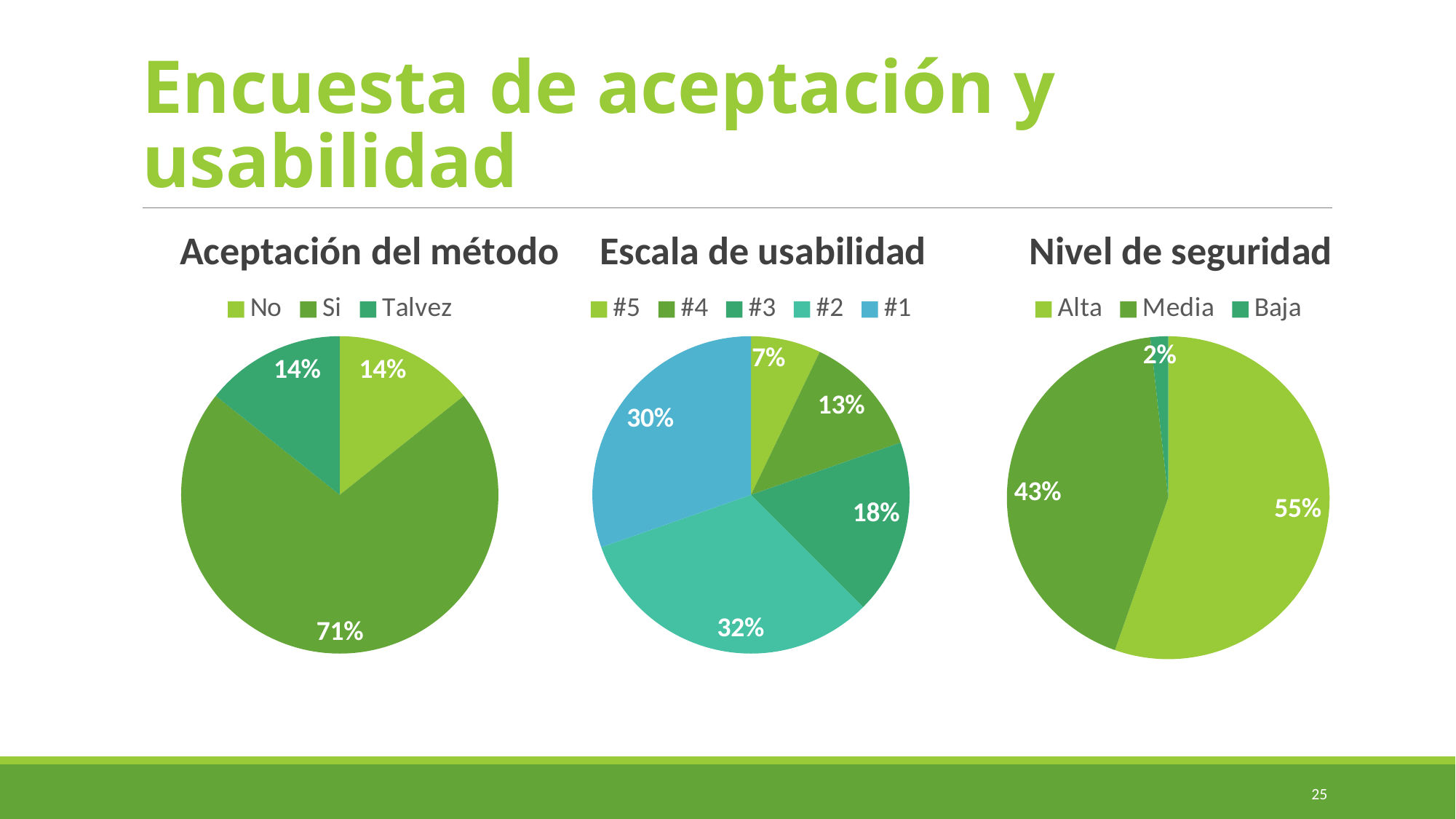
In the 'Escala de usabilidad' chart, what share does '#2' have? 32% In the 'Escala de usabilidad' chart, which is larger, '#4' or '#3'? #3 How many charts are shown on the slide? 3 In the 'Escala de usabilidad' chart, how many slices does the pie have? 5 In the 'Escala de usabilidad' chart, what is the difference between the shares of '#1' and '#3'? 12% In the 'Aceptación del método' chart, which category has the largest slice? Si In the 'Nivel de seguridad' chart, what share does 'Baja' have? 2% In the 'Nivel de seguridad' chart, what is the difference between the shares of 'Alta' and 'Media'? 12% In the 'Aceptación del método' chart, what share does 'Si' have? 71% What kind of chart is 'Nivel de seguridad'? Pie chart In the 'Escala de usabilidad' chart, which category has the smallest slice? #5 In the 'Aceptación del método' chart, how many categories does the legend list? 3